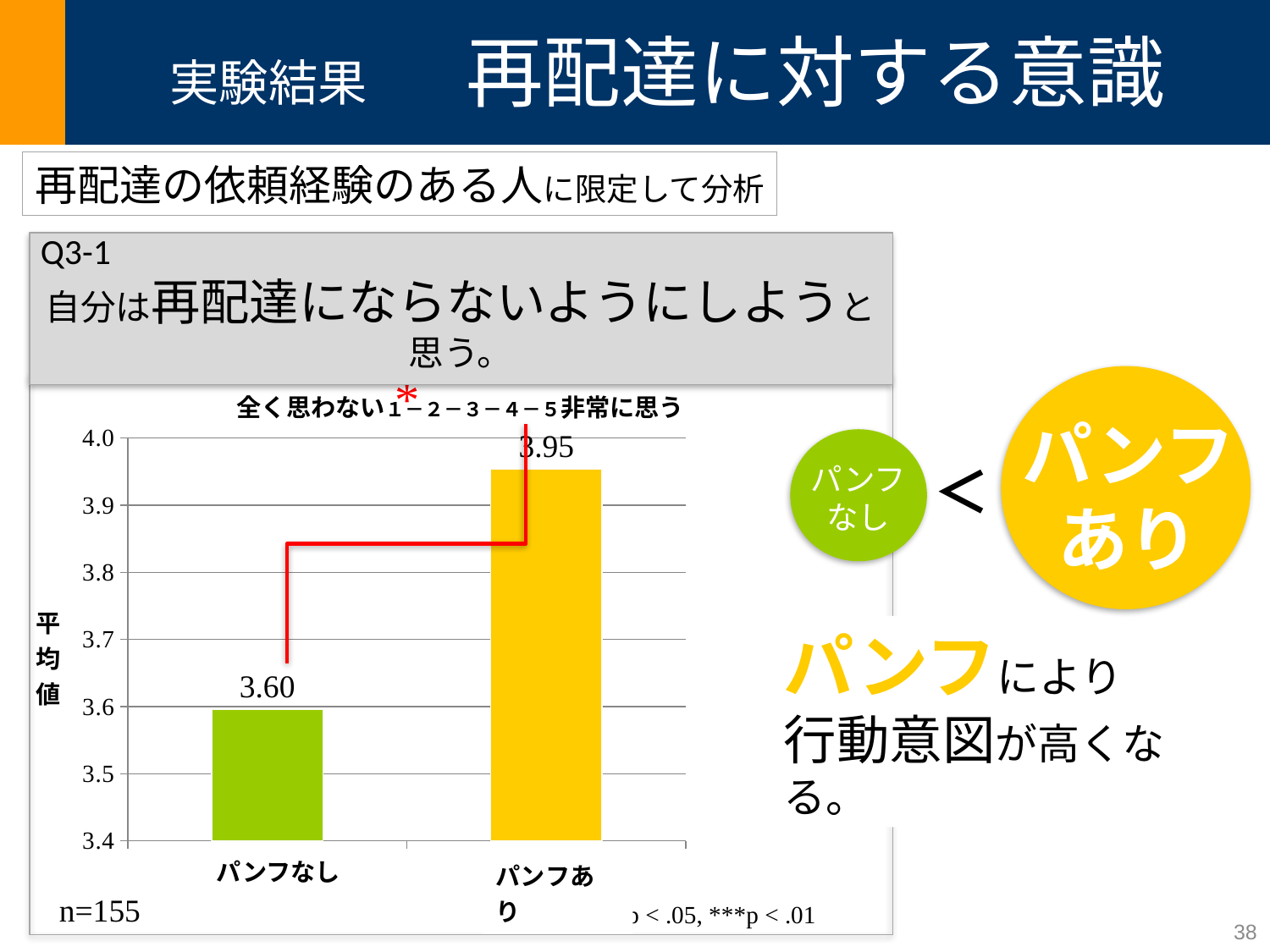
Which is larger, the value for パンフなし or the value for パンフあり? パンフあり What is the sample size (n) shown below the chart? n=155 Is the value for パンフなし greater or less than 3.7? less Is the value for パンフあり greater or less than 3.9? greater What is the difference between the values for パンフあり and パンフなし? 0.35 What is the label of the vertical axis? 平均値 What is the value for パンフあり? 3.95 Which category has the lowest value? パンフなし What is the value for パンフなし? 3.60 How many categories are shown in the chart? 2 What kind of chart is shown on the slide? bar chart Which category has the highest value? パンフあり